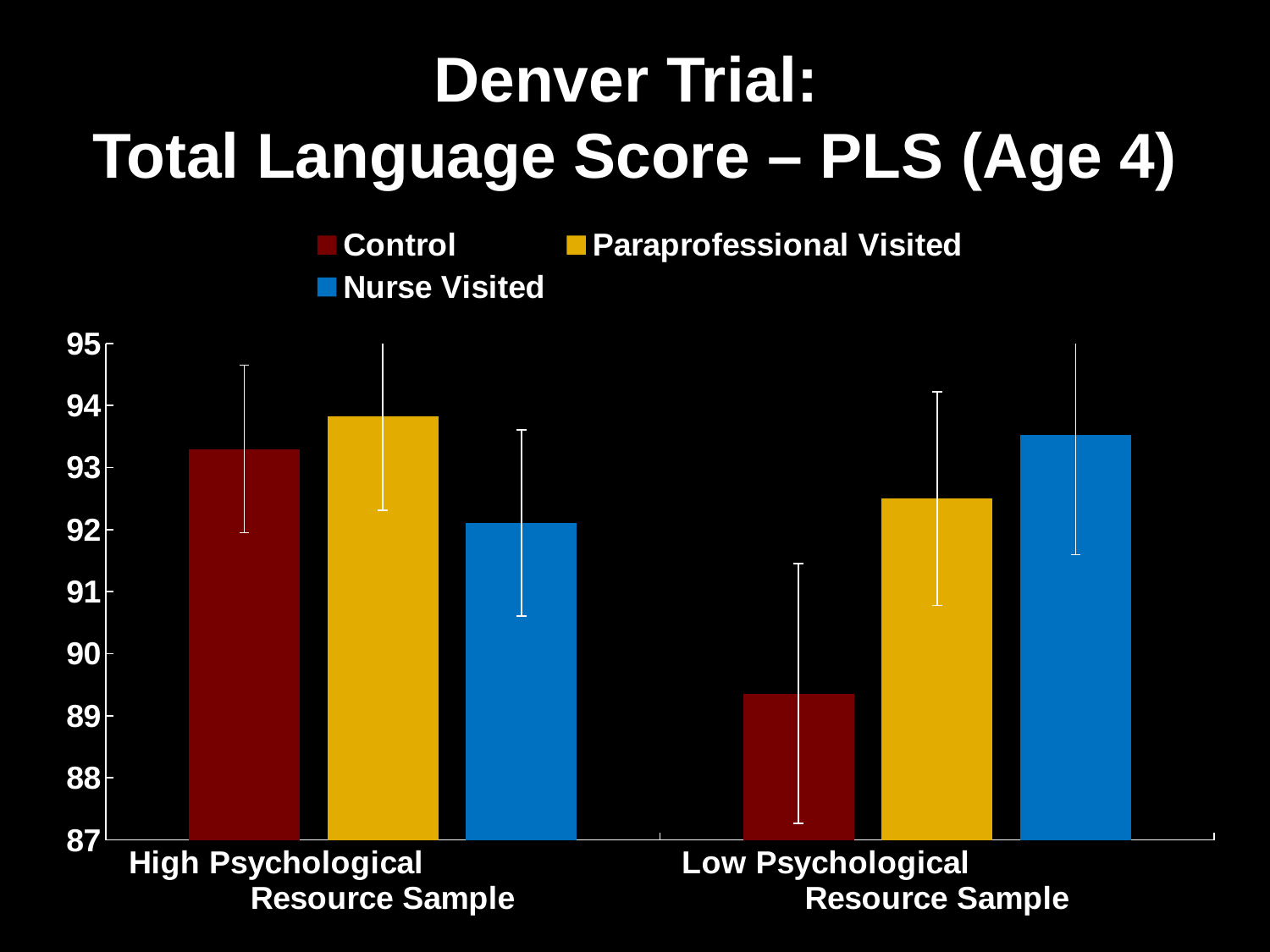
Is the Control value for the Low Psychological Resource Sample greater or less than 90? less Is the Nurse Visited value for the High Psychological Resource Sample greater or less than 93? less How many sample groups are shown on the x axis? 2 Is the Nurse Visited value for the Low Psychological Resource Sample greater or less than 93? greater Which series has the highest value in the Low Psychological Resource Sample? Nurse Visited Which is larger: the Control value for the High Psychological Resource Sample or the Control value for the Low Psychological Resource Sample? High Psychological Resource Sample How many series does the legend list? 3 Which colour represents the Nurse Visited series? blue Which series has the lowest value in the Low Psychological Resource Sample? Control Which series has the lowest value in the High Psychological Resource Sample? Nurse Visited What kind of chart is shown on the slide? bar chart